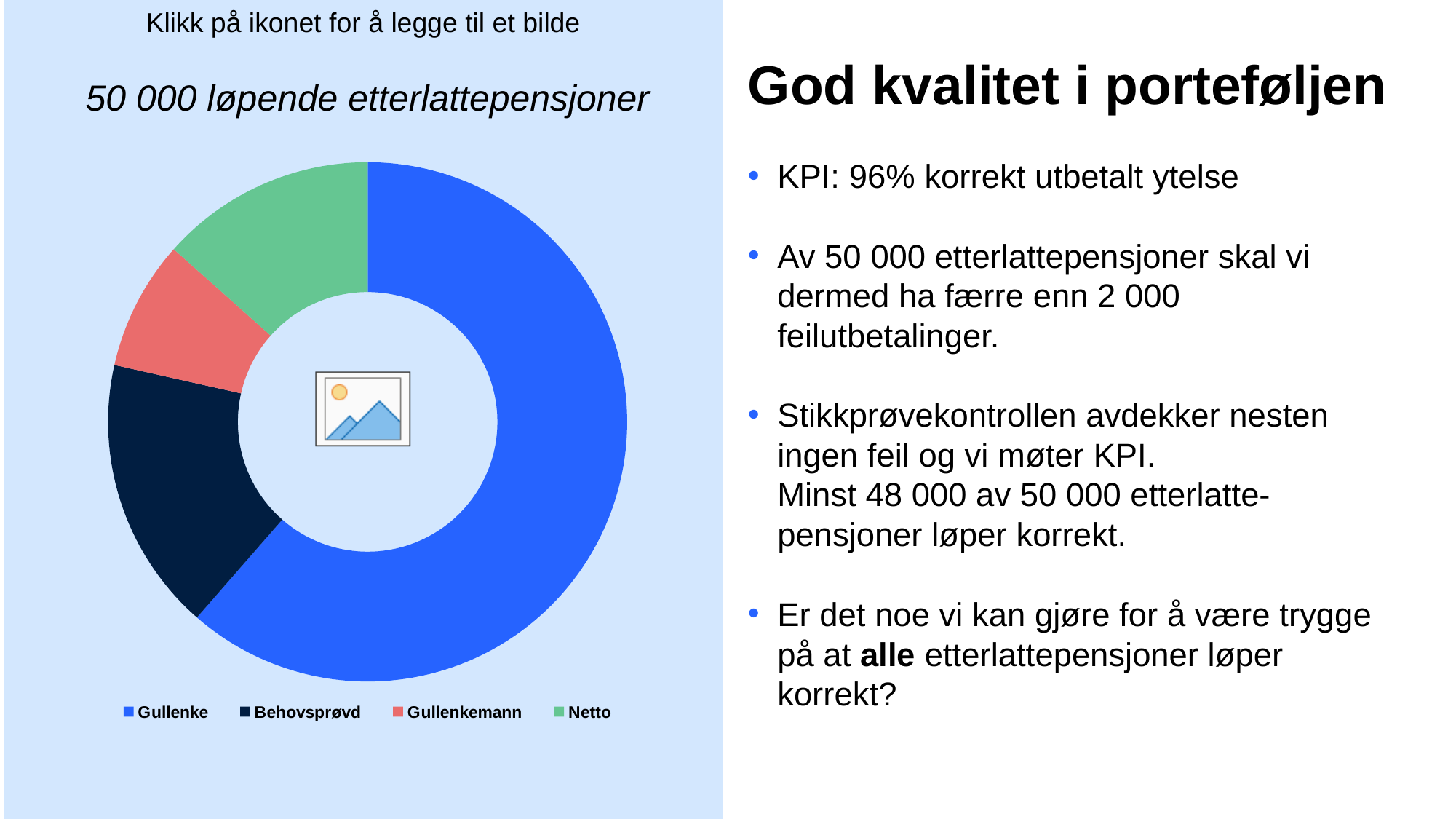
Does the Gullenke slice account for more or less than half of the doughnut chart? more What is the title of the doughnut chart? 50 000 løpende etterlattepensjoner What kind of chart is shown on the slide? doughnut chart Which category has the largest slice in the doughnut chart? Gullenke How many categories does the doughnut chart show? 4 Which slice is larger, Behovsprøvd or Netto? Behovsprøvd Which slice is larger, Netto or Gullenkemann? Netto Which colour represents Netto in the doughnut chart? green Which slice is larger, Gullenke or Behovsprøvd? Gullenke Which category has the smallest slice in the doughnut chart? Gullenkemann How many entries does the legend of the doughnut chart list? 4